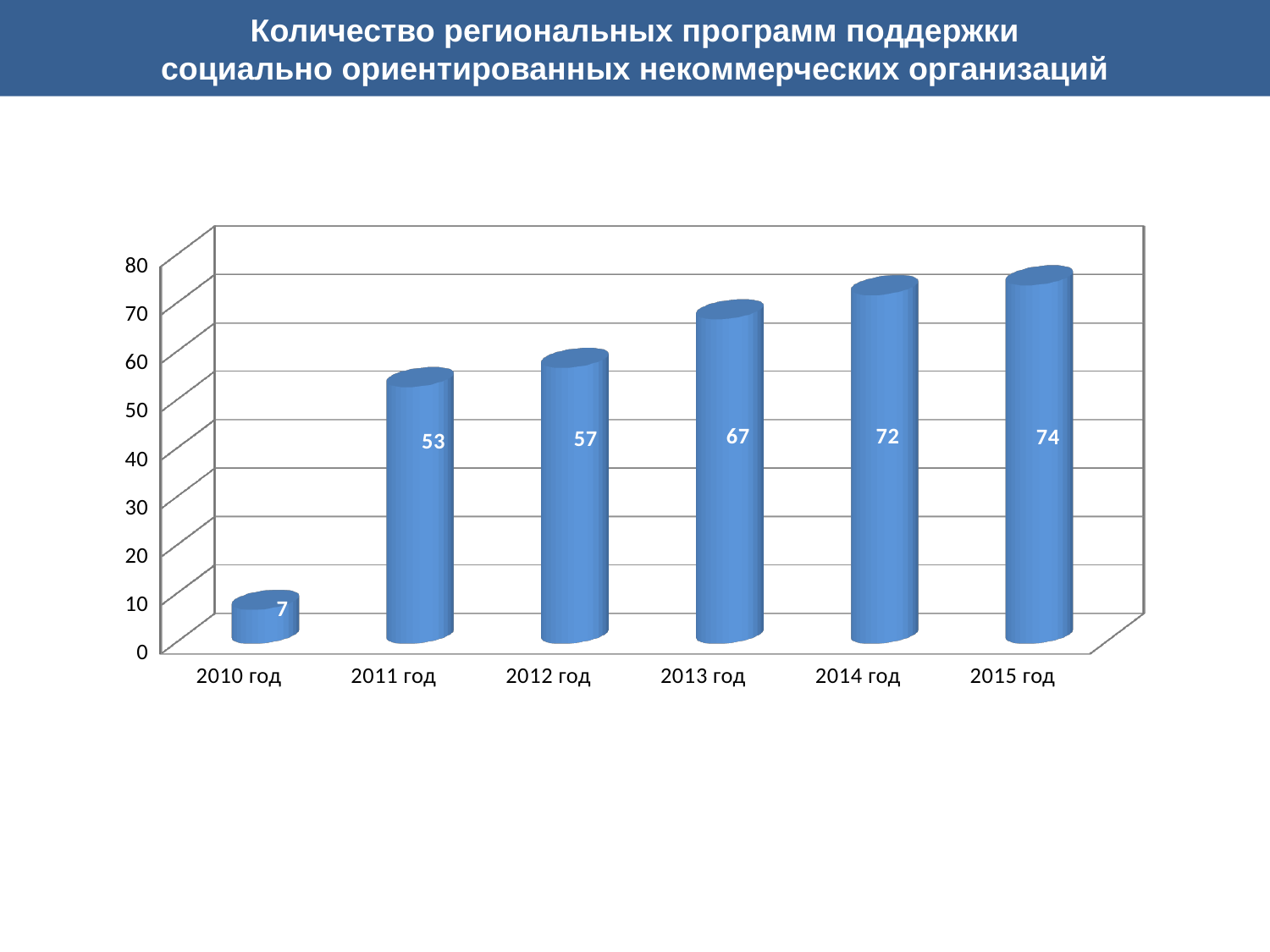
What is the value for 2010 год? 7 How many years are shown on the x axis? 6 What is the difference between the values for 2015 год and 2010 год? 67 Which year has the lowest value? 2010 год Is the value for 2014 год greater or less than 60? greater Which is larger, the value for 2012 год or the value for 2013 год? 2013 год What kind of chart is shown on the slide? bar chart What is the value for 2013 год? 67 Which year has the highest value? 2015 год Do the values rise or fall from 2010 год to 2015 год? rise What is the difference between the values for 2014 год and 2012 год? 15 What is the value for 2011 год? 53